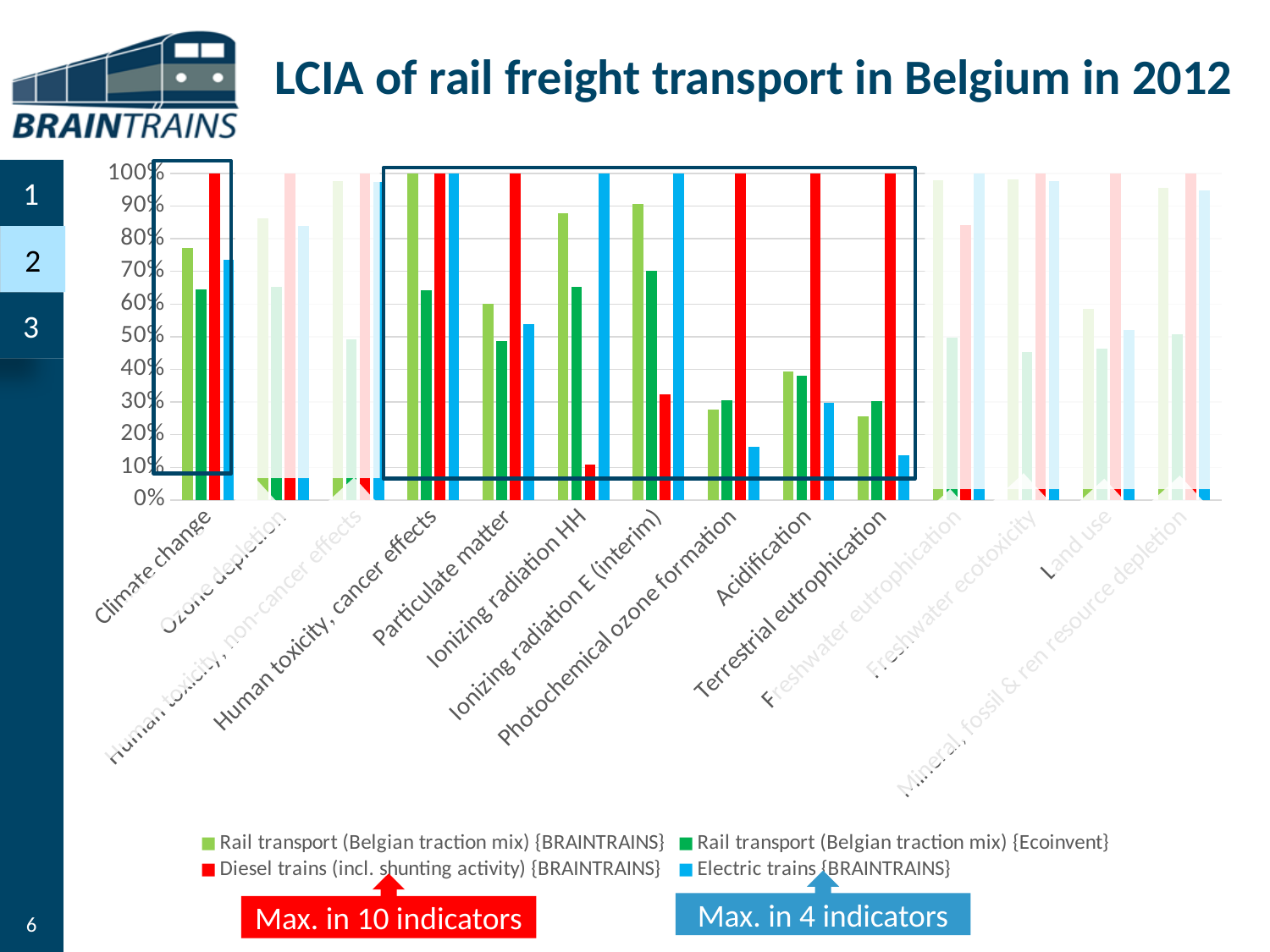
In the Terrestrial eutrophication category, which is larger: the value for Diesel trains (incl. shunting activity) {BRAINTRAINS} or the value for Electric trains {BRAINTRAINS}? Diesel trains (incl. shunting activity) {BRAINTRAINS} What is the title of the slide containing the chart? LCIA of rail freight transport in Belgium in 2012 What kind of chart is shown on the slide? bar chart Which series has the highest value in the Particulate matter category? Diesel trains (incl. shunting activity) {BRAINTRAINS} What is the value for Diesel trains (incl. shunting activity) {BRAINTRAINS} in the Climate change category? 100% What is the value for Diesel trains (incl. shunting activity) {BRAINTRAINS} in the Acidification category? 100% What is the value for Electric trains {BRAINTRAINS} in the Ionizing radiation HH category? 100% How many series does the chart legend list? 4 Is the value for Rail transport (Belgian traction mix) {BRAINTRAINS} in the Ionizing radiation E (interim) category greater or less than 80%? greater How many categories are shown along the x axis of the chart? 14 Is the value for Electric trains {BRAINTRAINS} in the Photochemical ozone formation category greater or less than 20%? less According to the annotation below the chart, in how many indicators are diesel trains the maximum? 10